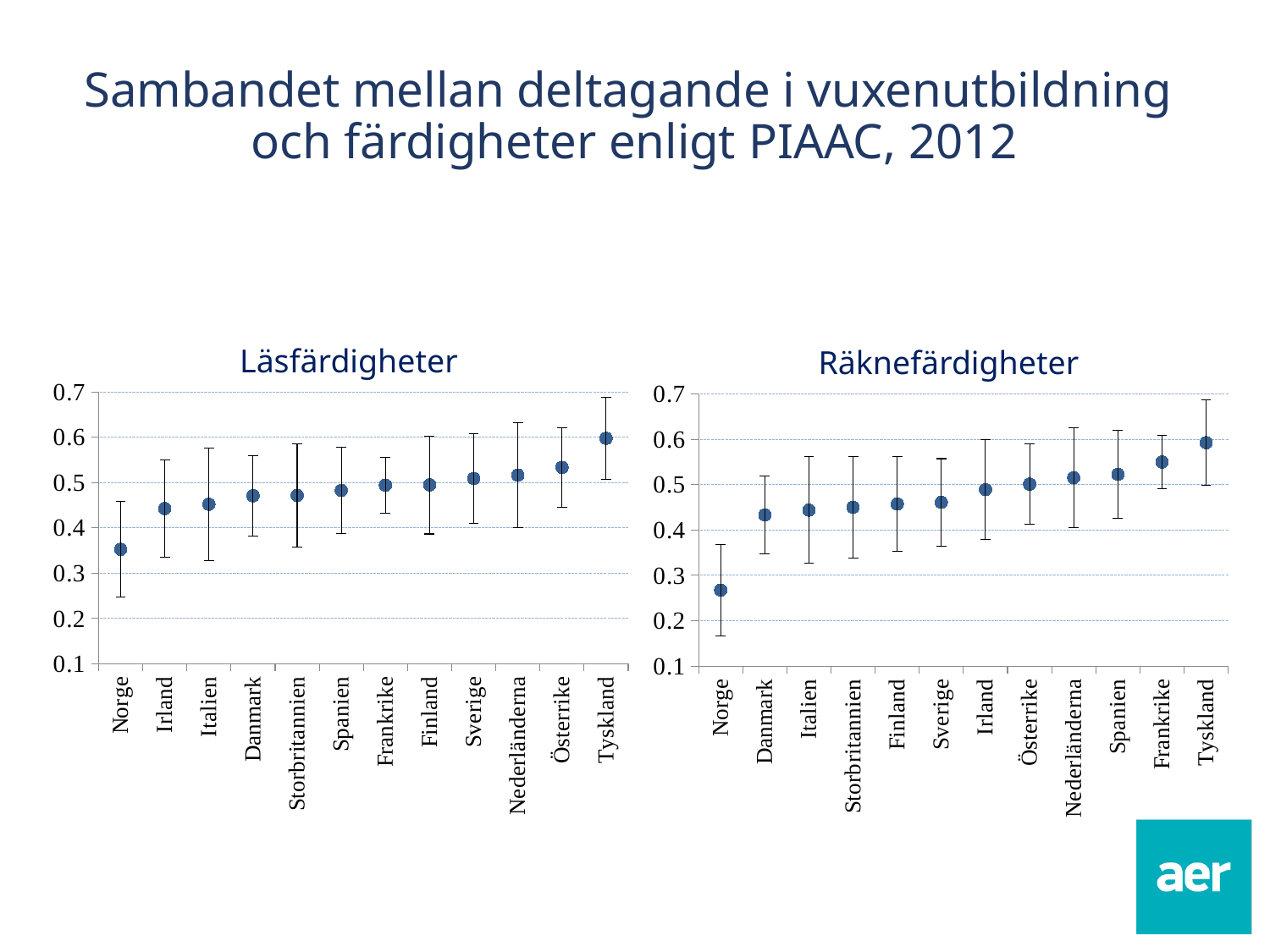
What are the titles of the two charts on the slide? Läsfärdigheter and Räknefärdigheter In the Läsfärdigheter chart, which country has the lowest value? Norge In the Läsfärdigheter chart, is the value for Norge greater or less than 0.4? less In the Räknefärdigheter chart, is the value for Danmark greater or less than 0.5? less In the Läsfärdigheter chart, which is larger, the value for Norge or the value for Tyskland? Tyskland In the Räknefärdigheter chart, which country has the lowest value? Norge In the Räknefärdigheter chart, do the values rise or fall from left to right along the x axis? rise In the Läsfärdigheter chart, is the value for Tyskland greater or less than 0.5? greater In the Räknefärdigheter chart, which country has the highest value? Tyskland How many countries are shown in the Räknefärdigheter chart? 12 In the Läsfärdigheter chart, which country has the highest value? Tyskland